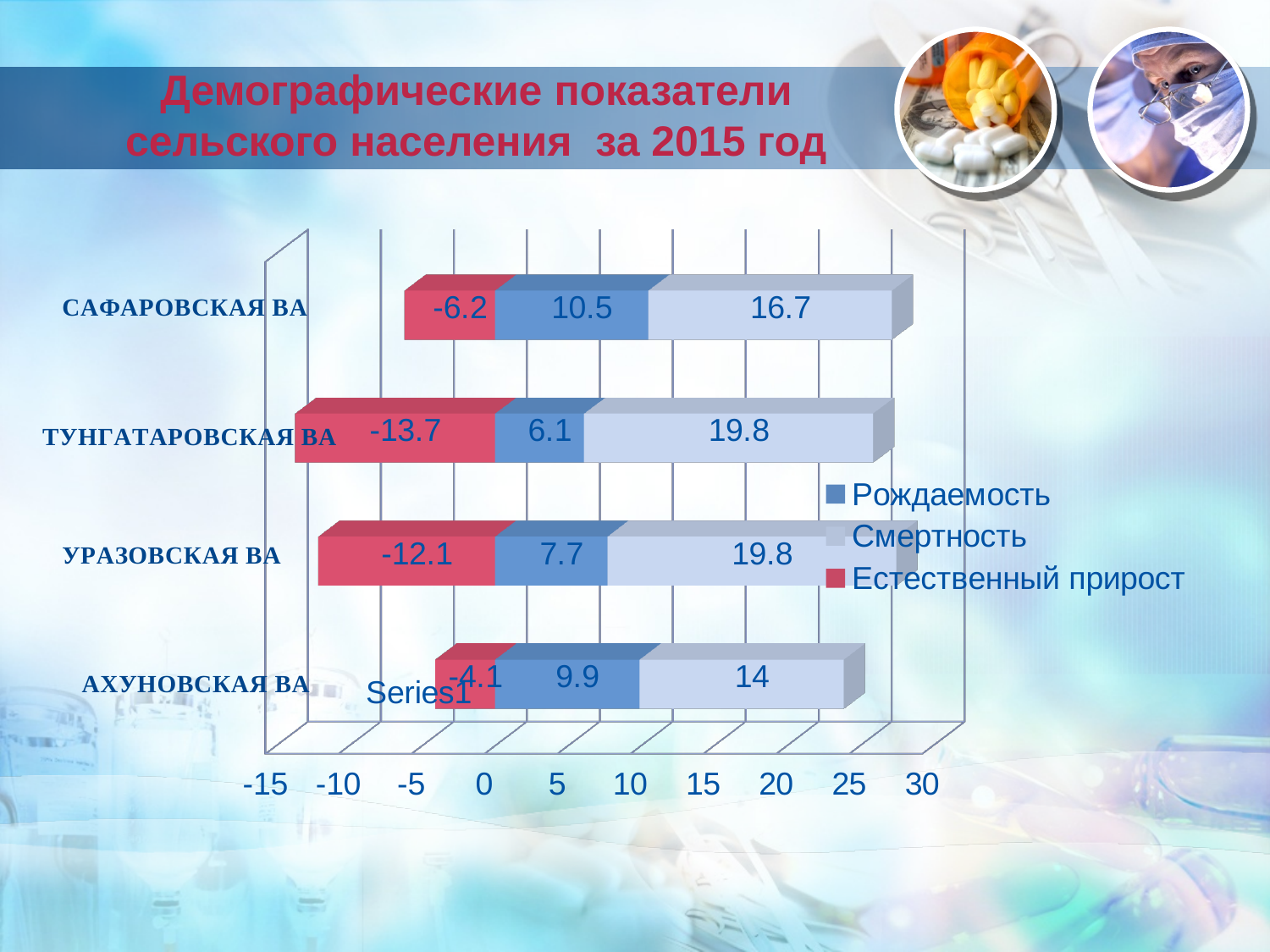
Which category has the highest Рождаемость value? САФАРОВСКАЯ ВА What is the Рождаемость value for САФАРОВСКАЯ ВА? 10.5 What is the Смертность value for ТУНГАТАРОВСКАЯ ВА? 19.8 What is the Естественный прирост value for УРАЗОВСКАЯ ВА? -12.1 Which is larger, the Рождаемость value for АХУНОВСКАЯ ВА or for ТУНГАТАРОВСКАЯ ВА? АХУНОВСКАЯ ВА How many categories are shown on the chart? 4 What is the difference between the Смертность and Рождаемость values for САФАРОВСКАЯ ВА? 6.2 Which category has the lowest Естественный прирост value? ТУНГАТАРОВСКАЯ ВА How many series does the legend list? 3 What kind of chart is shown on the slide? Bar chart Which category has the lowest Смертность value? АХУНОВСКАЯ ВА What is the Смертность value for АХУНОВСКАЯ ВА? 14